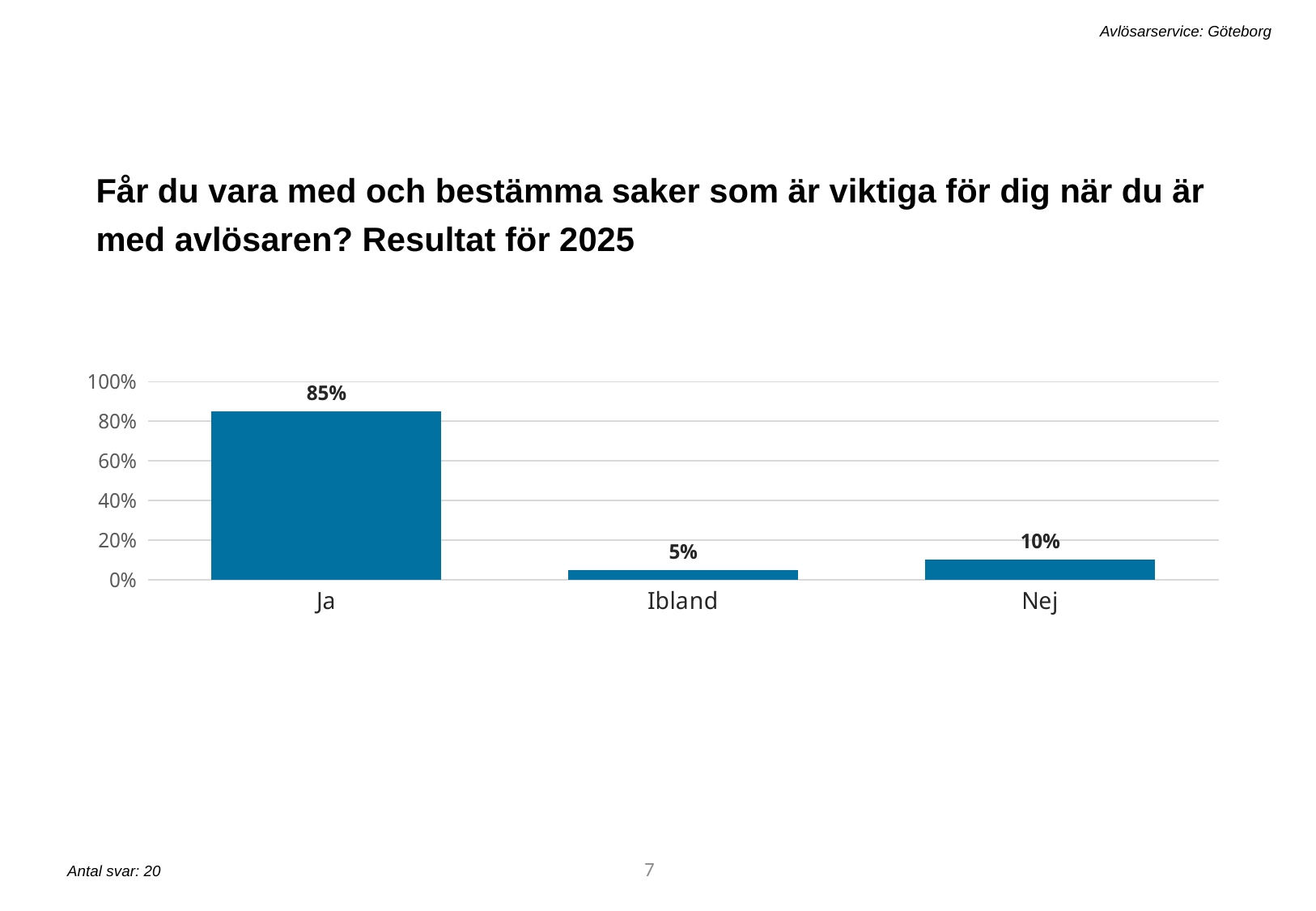
Which category has the lowest value? Ibland Which is larger, the value for Nej or the value for Ibland? Nej What is the value for Ibland? 5% What is the value for Ja? 85% What is the difference between the values for Nej and Ibland? 5% Which category has the highest value? Ja What is the value for Nej? 10% Is the value for Ja greater or less than 80%? greater How many categories are shown on the x axis? 3 What is the number of responses (Antal svar) stated on the slide? 20 What kind of chart is shown on the slide? bar chart What is the difference between the values for Ja and Nej? 75%